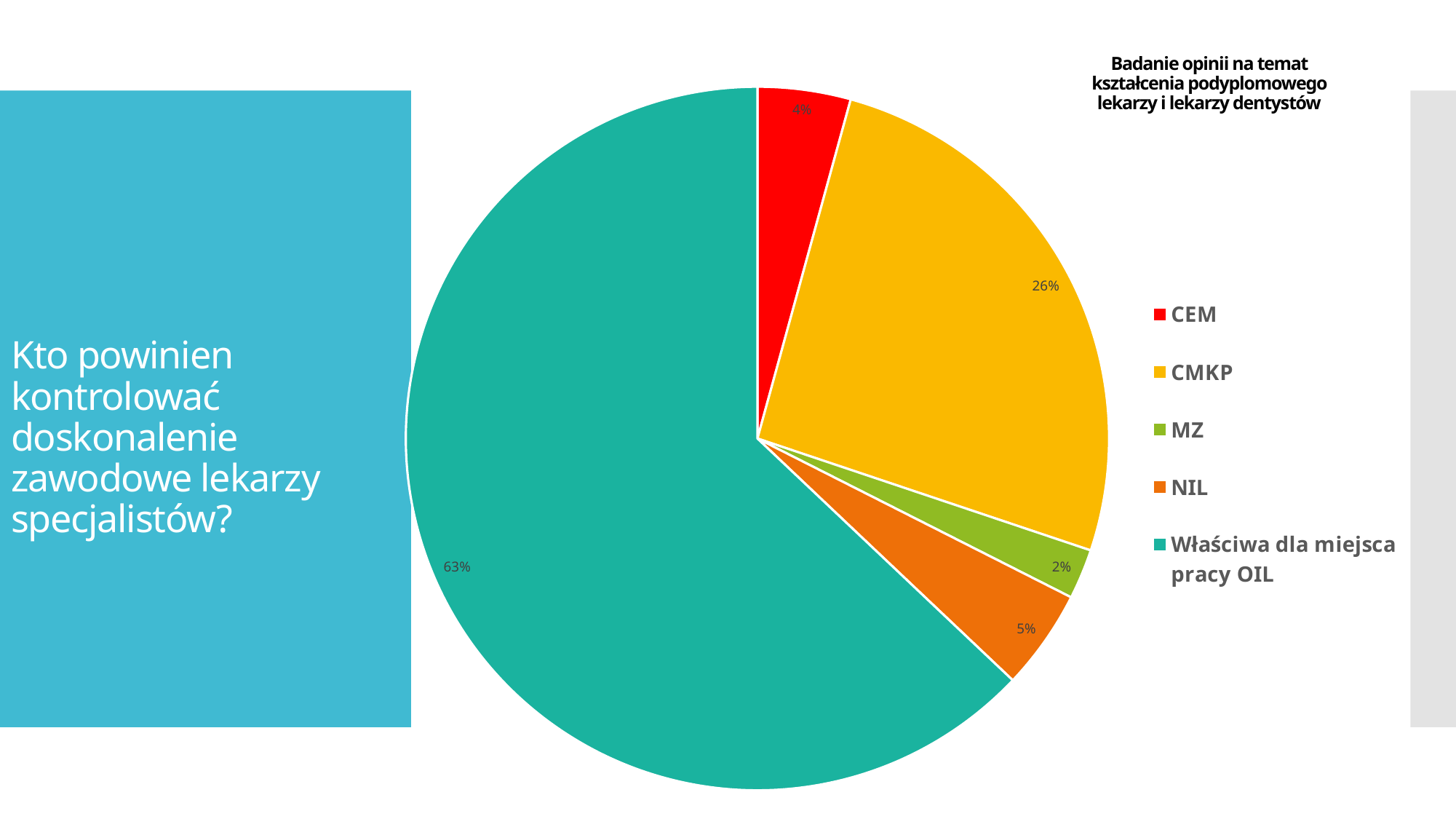
Which category has the smallest slice of the pie? MZ What share of the pie does Właściwa dla miejsca pracy OIL have? 63% How many categories does the pie chart have? 5 What share of the pie does CEM have? 4% What share of the pie does NIL have? 5% What colour is the slice for CMKP? yellow What kind of chart is shown on the slide? pie chart Which category has the largest slice of the pie? Właściwa dla miejsca pracy OIL Which is larger, the share for CEM or the share for NIL? NIL What is the difference between the shares of CMKP and NIL? 21%